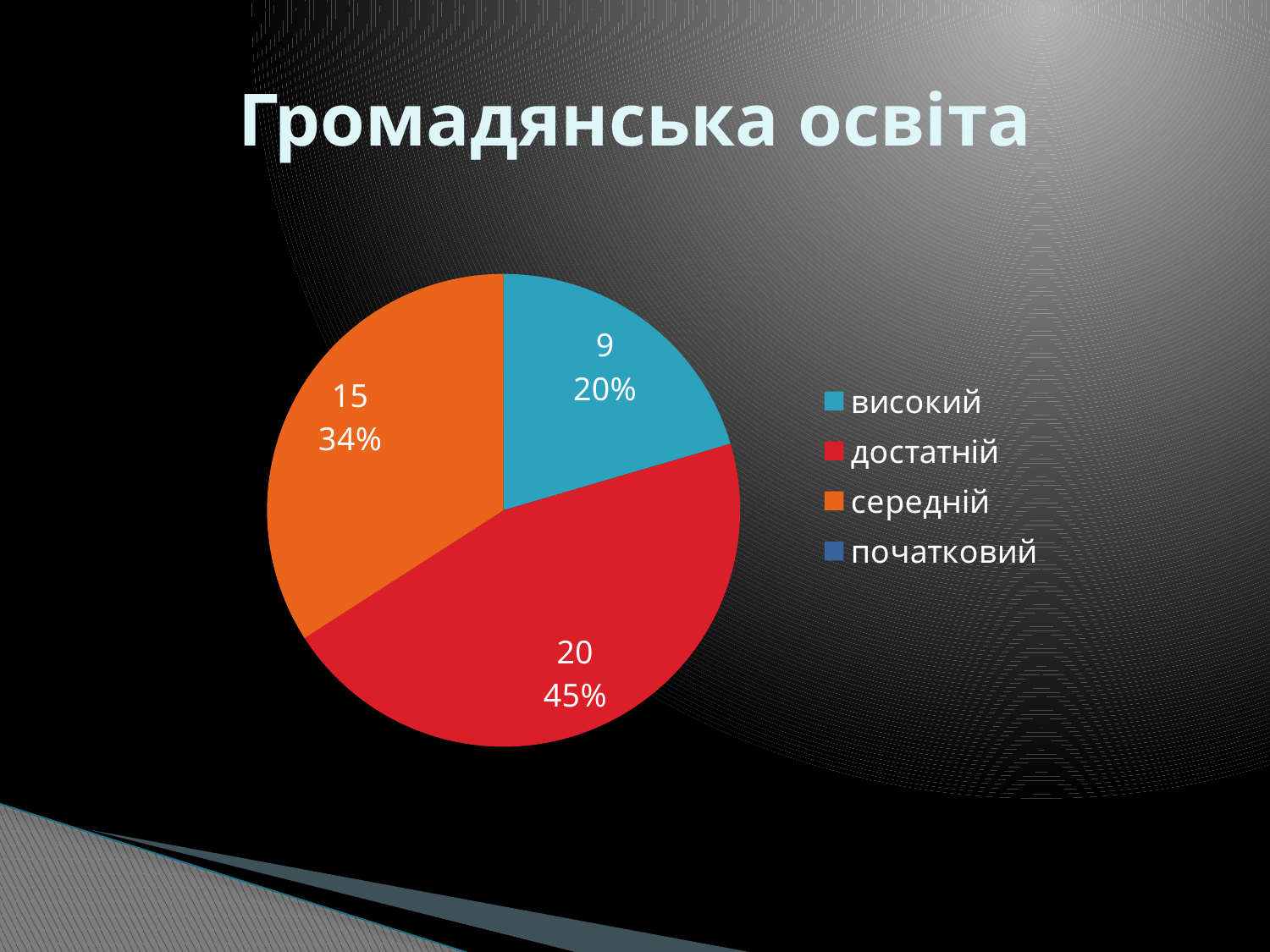
Which of the labelled slices is the smallest? високий Which category has the largest slice? достатній What is the title of the chart? Громадянська освіта What kind of chart is shown on the slide? pie chart What share of the pie does достатній take? 45% Which is larger, the value for середній or the value for високий? середній What is the value for середній? 15 What is the difference between the values for достатній and високий? 11 What is the value for достатній? 20 What share of the pie does середній take? 34% How many entries does the legend list? 4 What is the value for високий? 9